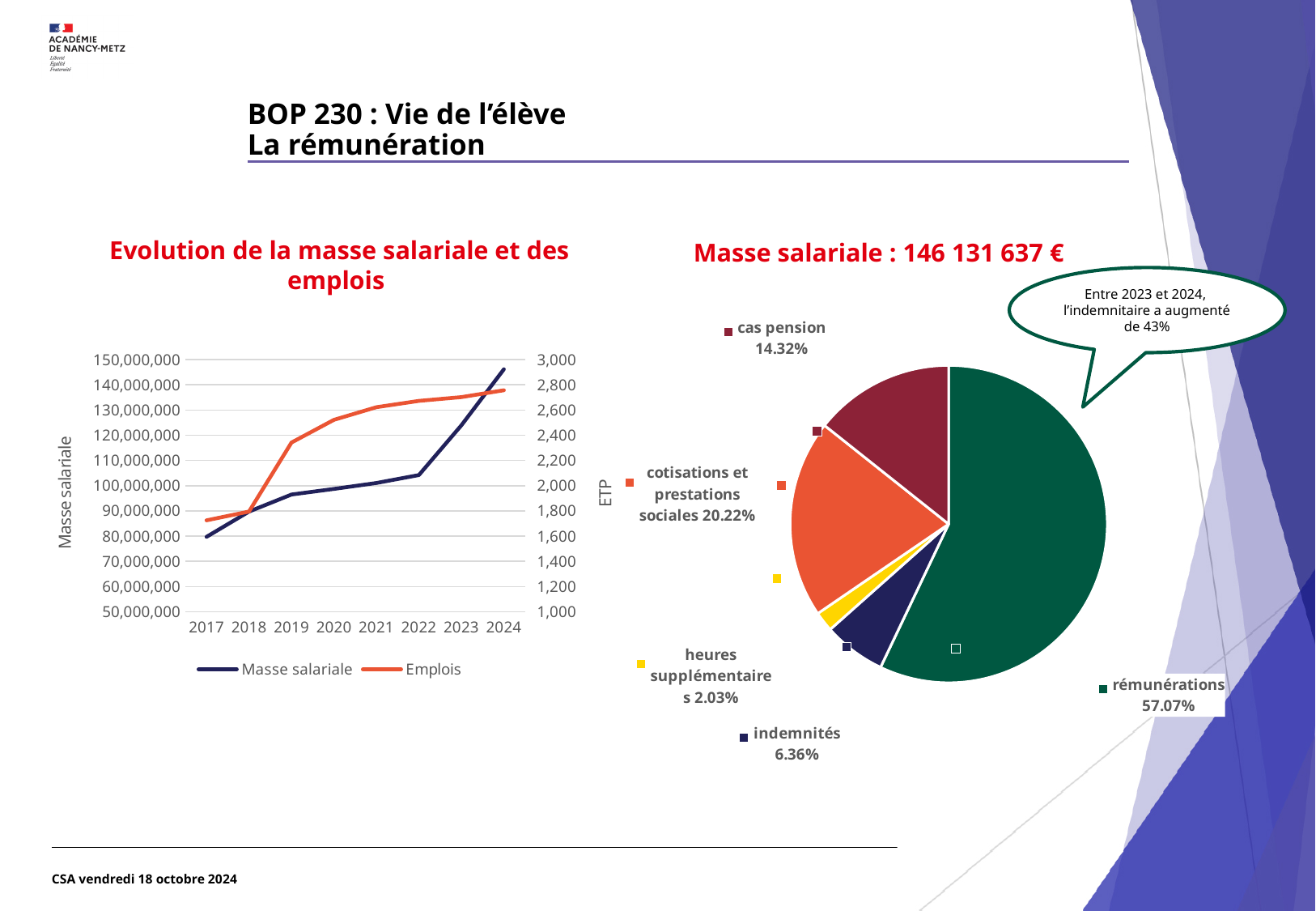
In the chart 'Evolution de la masse salariale et des emplois', how many series does the legend list? 2 In the pie chart 'Masse salariale : 146 131 637 €', what is the difference between the shares of rémunérations and cotisations et prestations sociales? 36.85% In the pie chart 'Masse salariale : 146 131 637 €', which category has the smallest share? heures supplémentaires In the chart 'Evolution de la masse salariale et des emplois', is the Masse salariale value for 2024 greater or less than 140,000,000? greater In the chart 'Evolution de la masse salariale et des emplois', does the Masse salariale series rise or fall from 2017 to 2024? rise What kind of chart is the chart titled 'Evolution de la masse salariale et des emplois'? line chart In the pie chart 'Masse salariale : 146 131 637 €', how many slices are there? 5 In the chart 'Evolution de la masse salariale et des emplois', is the Emplois value for 2017 greater or less than 2,000 ETP? less In the chart 'Evolution de la masse salariale et des emplois', is the Masse salariale value for 2017 greater or less than 90,000,000? less In the pie chart 'Masse salariale : 146 131 637 €', what is the share for cas pension? 14.32% In the chart 'Evolution de la masse salariale et des emplois', how many years are shown on the x axis? 8 In the pie chart 'Masse salariale : 146 131 637 €', which category has the largest share? rémunérations